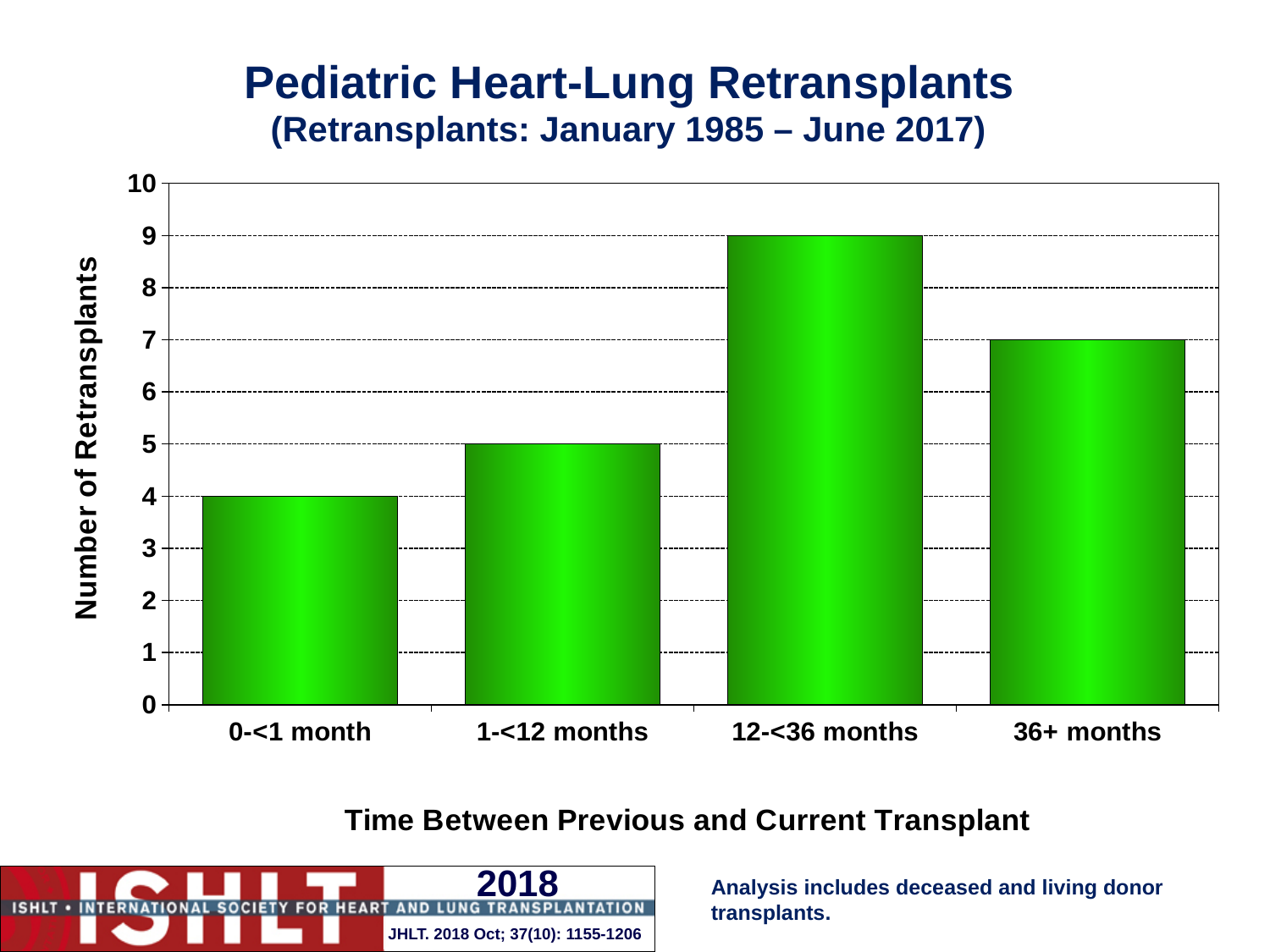
What kind of chart is shown on the slide? bar chart Which has more retransplants, the 1-<12 months category or the 36+ months category? 36+ months What is the number of retransplants for the 36+ months category? 7 What is the difference in number of retransplants between the 12-<36 months and 36+ months categories? 2 What is the label of the y axis? Number of Retransplants Which category has the lowest number of retransplants? 0-<1 month Which category has the highest number of retransplants? 12-<36 months How many categories are shown on the x axis? 4 What is the label of the x axis? Time Between Previous and Current Transplant What is the number of retransplants for the 1-<12 months category? 5 What is the number of retransplants for the 12-<36 months category? 9 What is the number of retransplants for the 0-<1 month category? 4